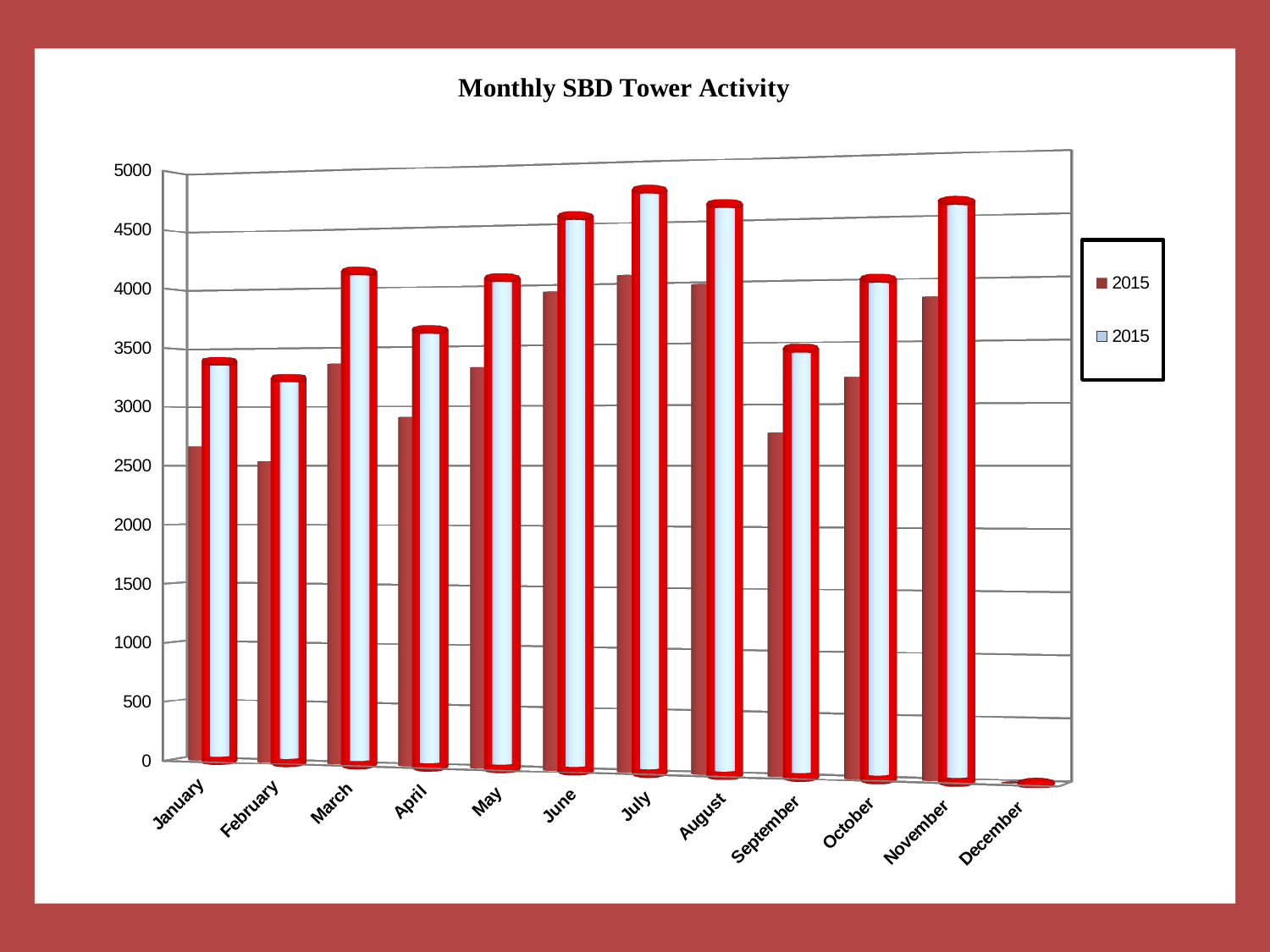
What kind of chart is shown on the slide? bar chart Is the dark red bar for January greater or less than 3000? less How many series does the legend list? 2 Do the dark red bars rise or fall from January to February? fall Which is larger, the light blue bar for June or the light blue bar for September? June Is the dark red bar for June greater or less than 3500? greater Is the light blue bar for April greater or less than 4000? less How many months are shown along the x axis of the chart? 12 What is the title of the chart? Monthly SBD Tower Activity Which month has the tallest light blue bar? July Which month has the lowest values in the chart? December